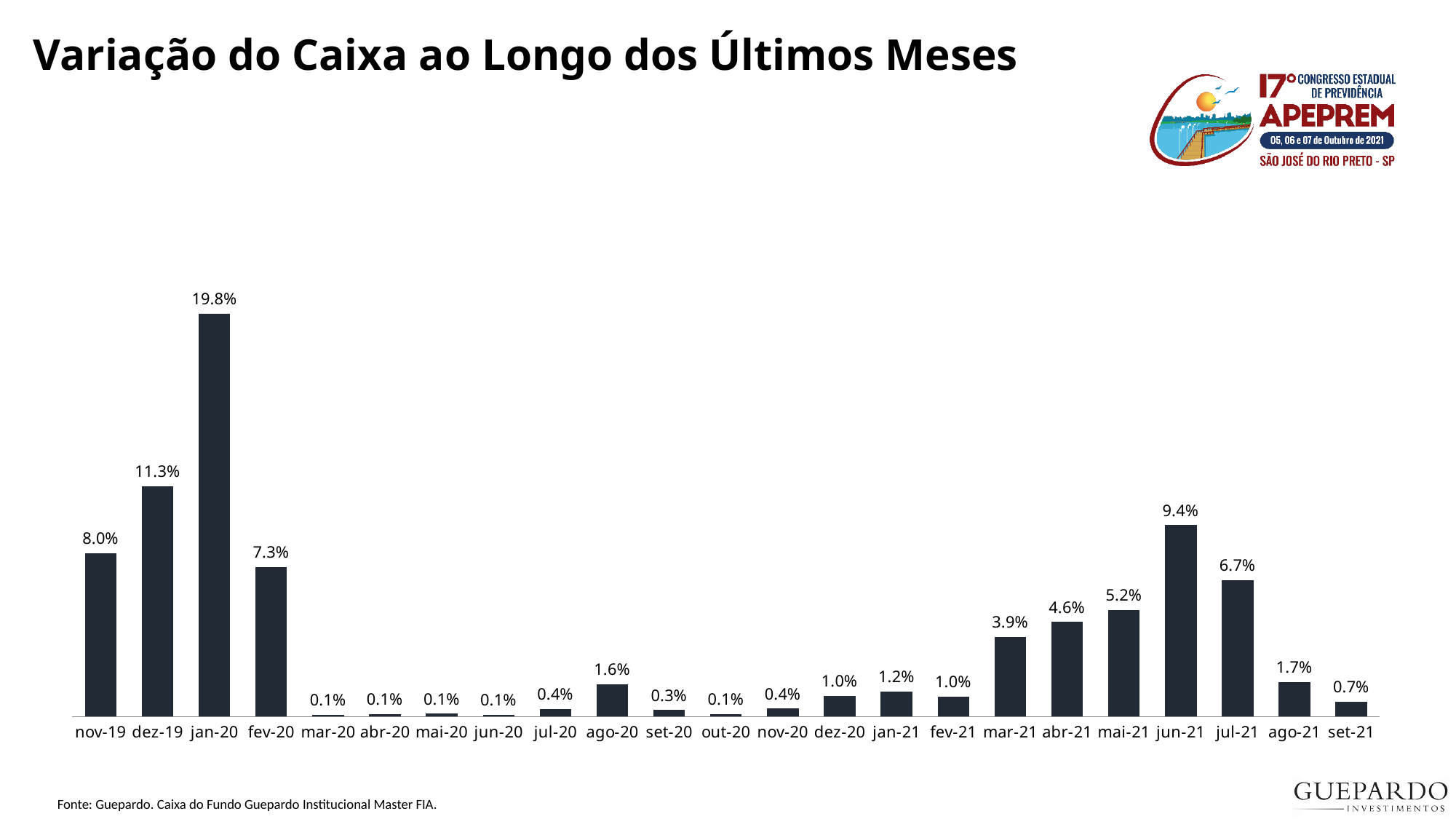
Which is larger, the value for mar-21 or the value for mai-21? mai-21 What is the value for jun-21? 9.4% What is the difference between the values for jan-20 and dez-19? 8.5% Which month has the highest value? jan-20 What is the title of the chart? Variação do Caixa ao Longo dos Últimos Meses How many months are shown on the x axis? 23 What is the value for set-21? 0.7% Which is larger, the value for nov-19 or the value for fev-20? nov-19 What is the value for jan-20? 19.8% What kind of chart is shown on the slide? bar chart What is the difference between the values for jun-21 and jul-21? 2.7% What is the value for ago-20? 1.6%